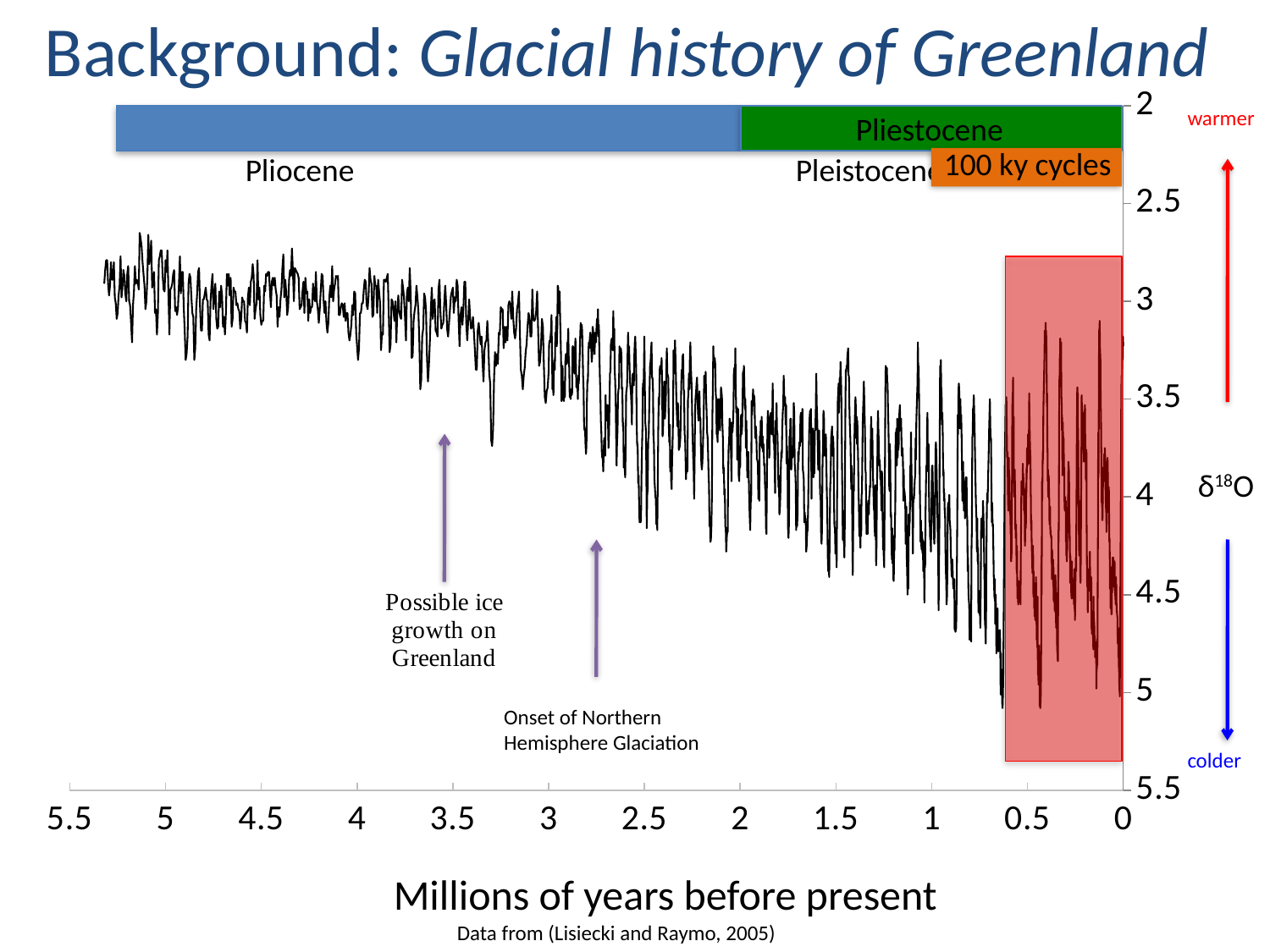
As the line approaches 0 on the x axis (the present), does it move toward warmer or colder values? colder Is the δ18O value at 0.5 million years before present greater or less than 3? greater What is the label of the x axis of the chart? Millions of years before present What quantity is plotted on the y axis of the chart? δ18O What kind of chart is shown on the slide? line chart Is the δ18O value at 5 million years before present greater or less than 4? less Which has the larger δ18O value: the point at 5 million years before present or the point at 0.5 million years before present? 0.5 million years before present Is the δ18O value at 5 million years before present greater or less than 2.5? greater